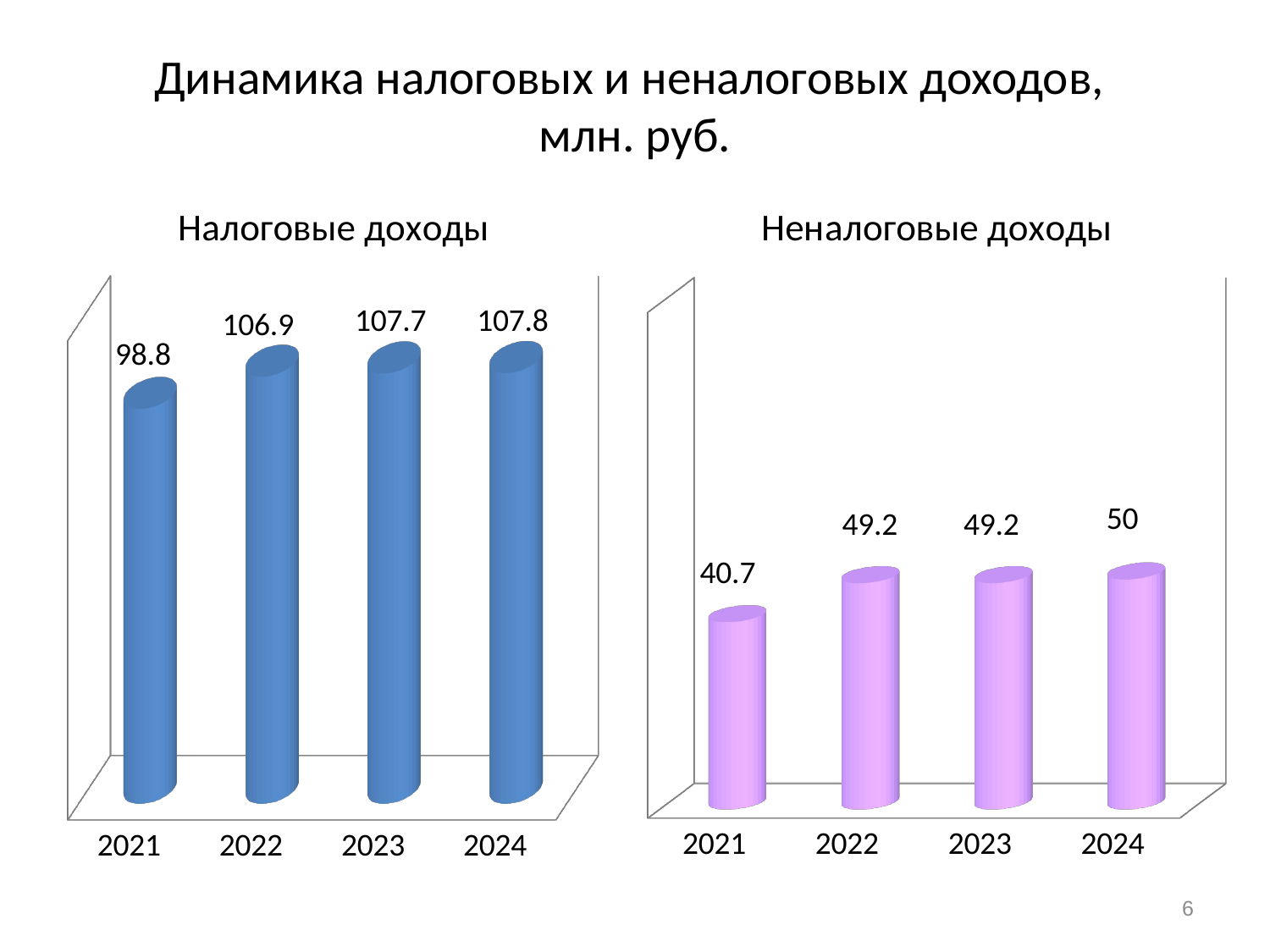
In the "Налоговые доходы" chart, which is larger: the value for 2021 or the value for 2022? 2022 In the "Налоговые доходы" chart, what is the difference between the values for 2022 and 2021? 8.1 What kind of chart is the "Неналоговые доходы" chart? bar chart In the "Неналоговые доходы" chart, what is the value for 2024? 50 In the "Неналоговые доходы" chart, what is the value for 2022? 49.2 In the "Налоговые доходы" chart, which year has the lowest value? 2021 In the "Неналоговые доходы" chart, which year has the lowest value? 2021 In the "Налоговые доходы" chart, what is the value for 2021? 98.8 In the "Неналоговые доходы" chart, what is the difference between the values for 2024 and 2021? 9.3 How many years are shown in the "Налоговые доходы" chart? 4 What is the title of the slide? Динамика налоговых и неналоговых доходов, млн. руб. In the "Налоговые доходы" chart, do the values rise or fall from 2021 to 2024? rise